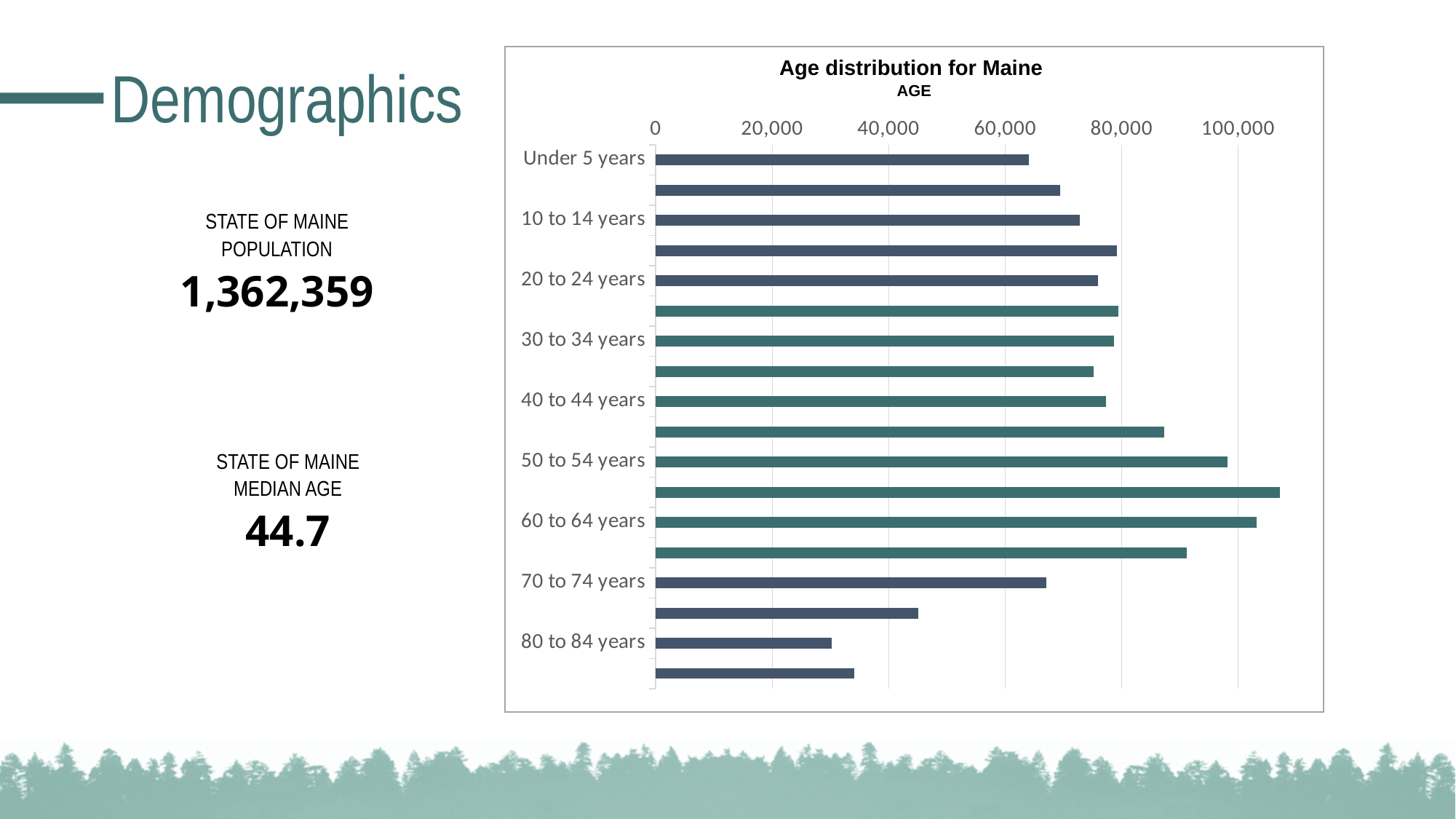
Is the value for 60 to 64 years greater or less than 100,000? greater Which age group has the shortest bar in the chart? 80 to 84 years Which is larger, the value for 60 to 64 years or the value for Under 5 years? 60 to 64 years Is the value for 50 to 54 years greater or less than 80,000? greater How many age group labels are shown on the vertical axis of the chart? 9 Is the value for 70 to 74 years greater or less than 60,000? greater What kind of chart is shown on the slide? bar chart What is the title of the chart? Age distribution for Maine Which is larger, the value for 50 to 54 years or the value for 70 to 74 years? 50 to 54 years